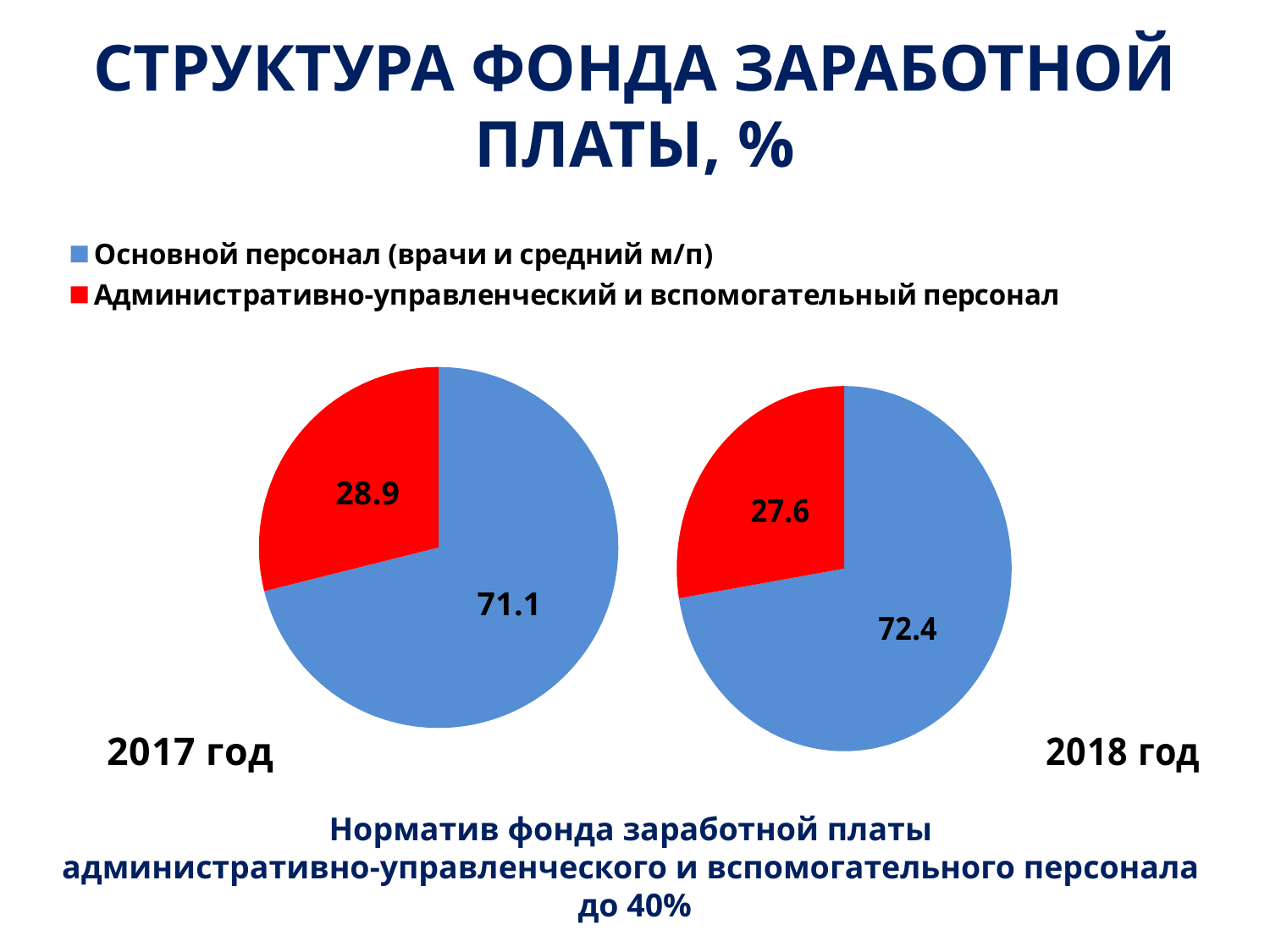
In the 2017 год pie chart, what is the value for Основной персонал (врачи и средний м/п)? 71.1 In the 2017 год pie chart, what is the value for Административно-управленческий и вспомогательный персонал? 28.9 In the 2018 год pie chart, which category has the largest slice? Основной персонал (врачи и средний м/п) In the 2017 год pie chart, what is the difference between the Основной персонал slice and the Административно-управленческий и вспомогательный персонал slice? 42.2 What colour represents Административно-управленческий и вспомогательный персонал in the pie charts? Red In the 2018 год pie chart, what is the value for Административно-управленческий и вспомогательный персонал? 27.6 In the 2017 год pie chart, which category has the smallest slice? Административно-управленческий и вспомогательный персонал Which is larger: the Административно-управленческий и вспомогательный персонал value in 2017 год or in 2018 год? 2017 год What type of chart is used on this slide? Pie chart How many slices does the 2018 год pie chart have? 2 How many series does the legend list? 2 In the 2018 год pie chart, what is the value for Основной персонал (врачи и средний м/п)? 72.4